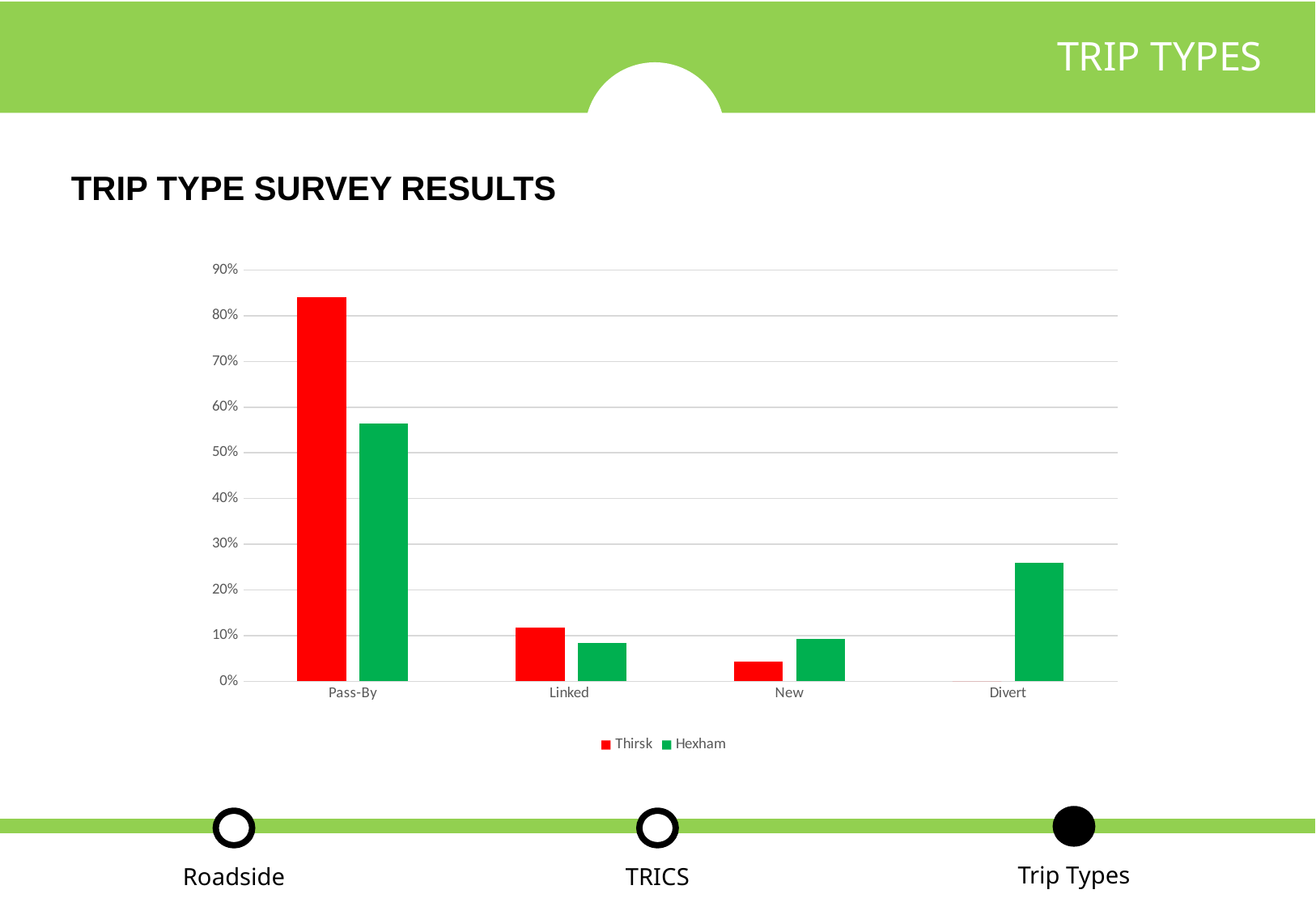
How many series does the legend list? 2 Is the Hexham value for Divert greater or less than 30%? less What kind of chart is shown on the slide? bar chart Which trip type has the lowest value for Hexham? Linked For Divert, which series has the larger value, Thirsk or Hexham? Hexham For New, which series has the larger value, Thirsk or Hexham? Hexham How many trip type categories are shown on the x axis? 4 Is the Thirsk value for Pass-By greater or less than 80%? greater Which series is shown in red in the legend? Thirsk Which trip type has the highest value for Hexham? Pass-By For Pass-By, which series has the larger value, Thirsk or Hexham? Thirsk Which trip type has the highest value for Thirsk? Pass-By